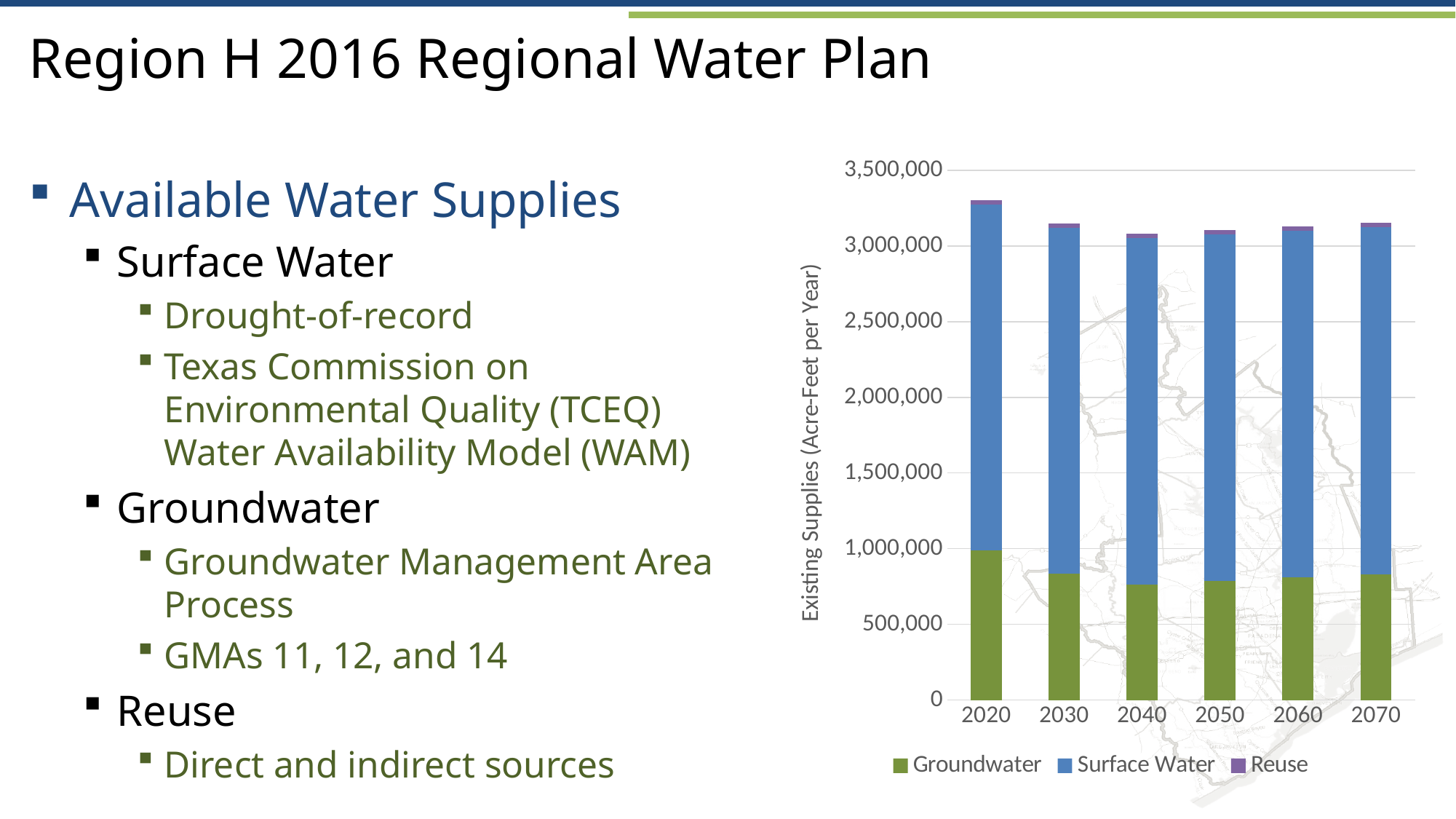
Is the total existing supply for 2020 greater or less than 3,000,000? greater Which year has the highest total existing supplies? 2020 Which is larger, the total existing supply in 2020 or in 2030? 2020 Is the Groundwater value for 2070 greater or less than 1,000,000? less How many years are shown on the x axis of the chart? 6 What kind of chart is shown on the slide? Stacked bar chart Which year has the largest Groundwater value? 2020 Is the Groundwater value for 2040 greater or less than 500,000? greater What is the label on the vertical axis of the chart? Existing Supplies (Acre-Feet per Year) How many series does the chart legend list? 3 Do total existing supplies rise or fall from 2020 to 2040? fall